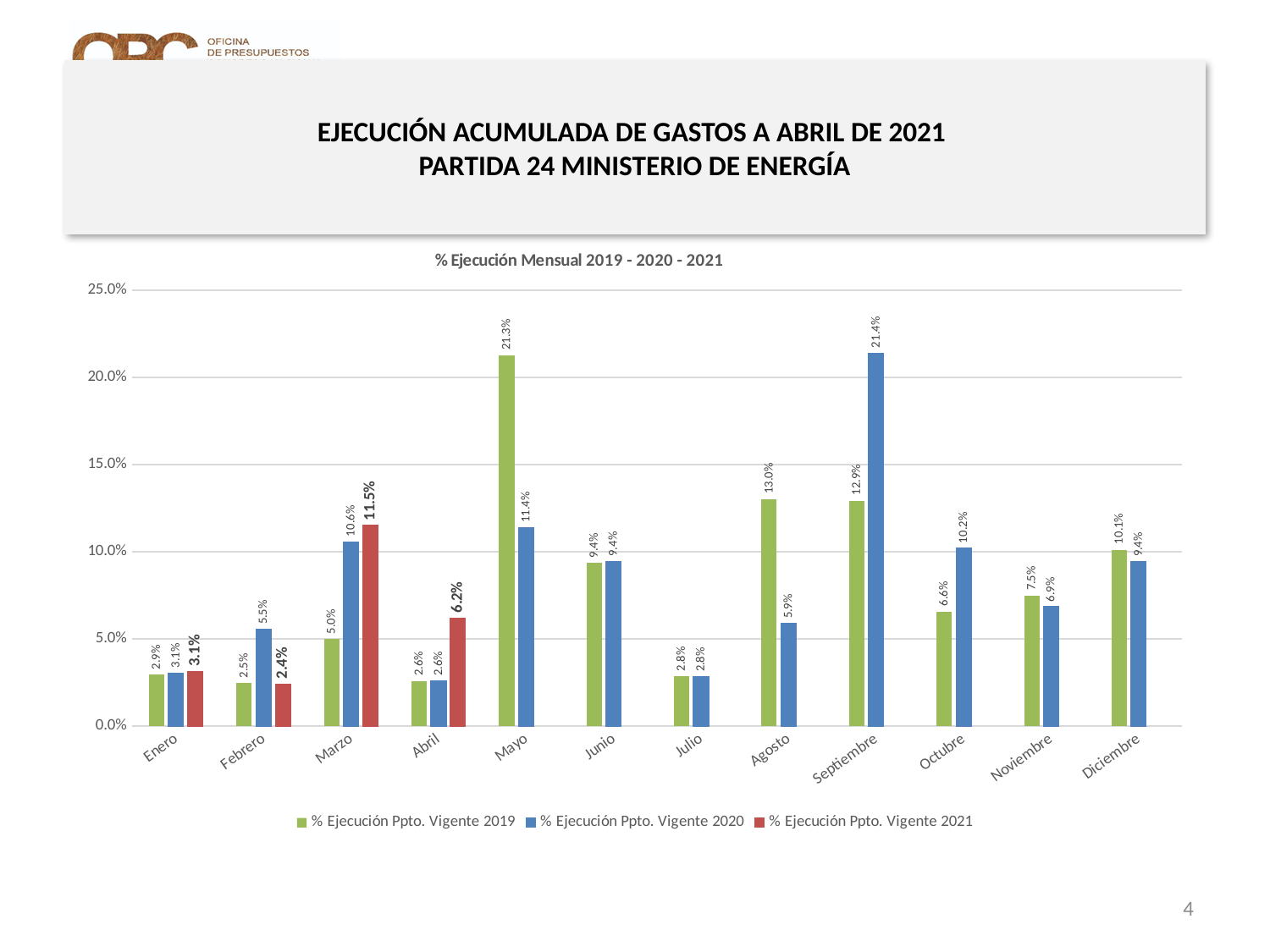
How many series does the legend list? 3 How many months are shown on the x axis? 12 What is the difference between the 2019 and 2020 values in Agosto? 7.1% What kind of chart is shown? Bar chart Which month has the highest value for % Ejecución Ppto. Vigente 2019? Mayo What is the title of the chart? % Ejecución Mensual 2019 - 2020 - 2021 What is the value for % Ejecución Ppto. Vigente 2021 in Abril? 6.2% What is the value for % Ejecución Ppto. Vigente 2019 in Mayo? 21.3% Which month has the lowest value for % Ejecución Ppto. Vigente 2021? Febrero What is the value for % Ejecución Ppto. Vigente 2021 in Marzo? 11.5% Which is larger in Octubre, the 2019 value or the 2020 value? 2020 What is the value for % Ejecución Ppto. Vigente 2020 in Septiembre? 21.4%